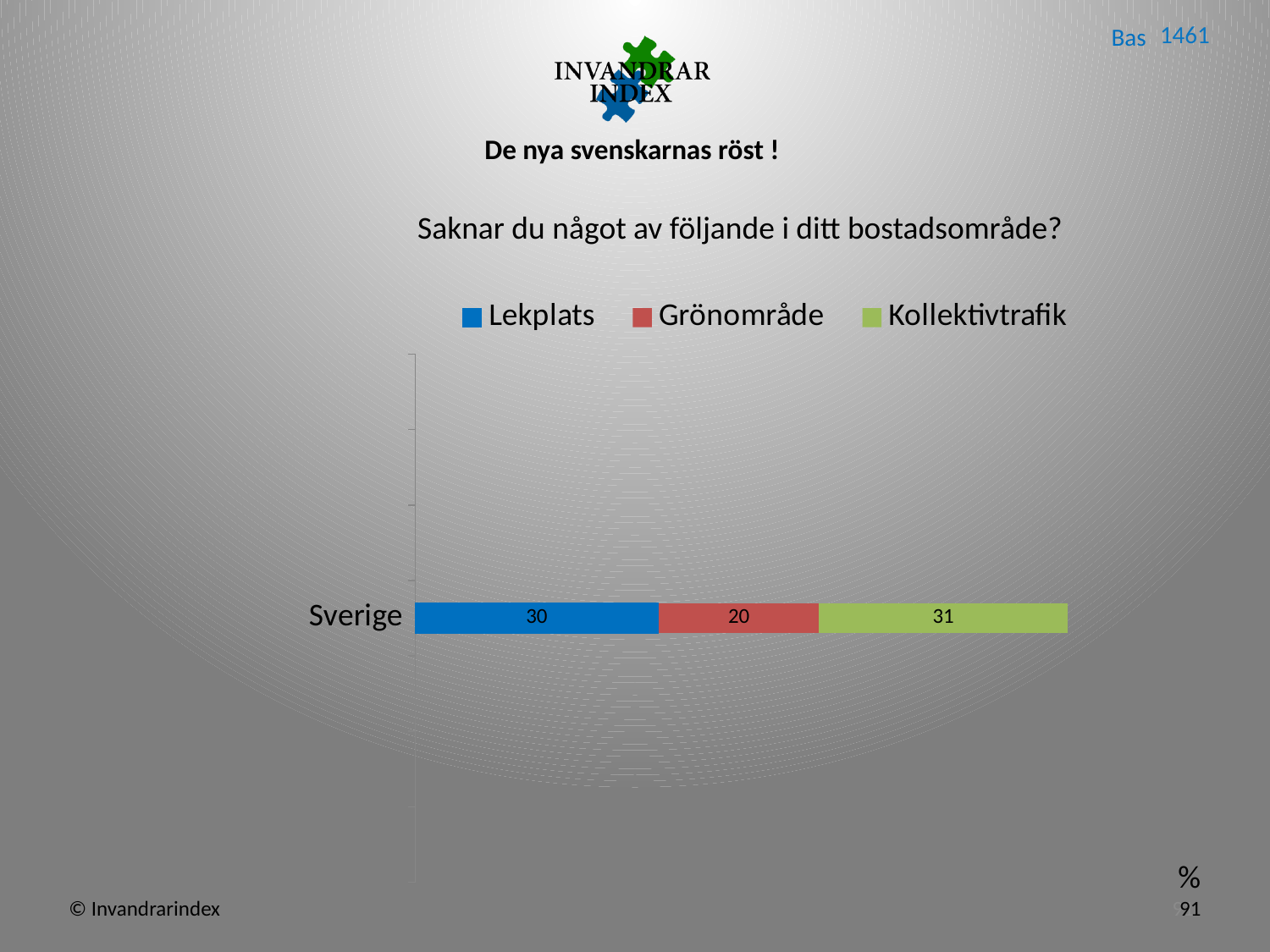
Which series has the lowest value for Sverige? Grönområde Which is larger for Sverige, Lekplats or Grönområde? Lekplats How many series does the legend list? 3 What is the value for Kollektivtrafik for Sverige? 31 What is the title of the chart? Saknar du något av följande i ditt bostadsområde? How many categories are shown on the chart? 1 What is the value for Lekplats for Sverige? 30 What is the difference between the Kollektivtrafik and Grönområde values for Sverige? 11 What kind of chart is shown on the slide? Stacked bar chart What is the value for Grönområde for Sverige? 20 What is the total of the stacked bar for Sverige? 81 What is the difference between the Lekplats and Grönområde values for Sverige? 10